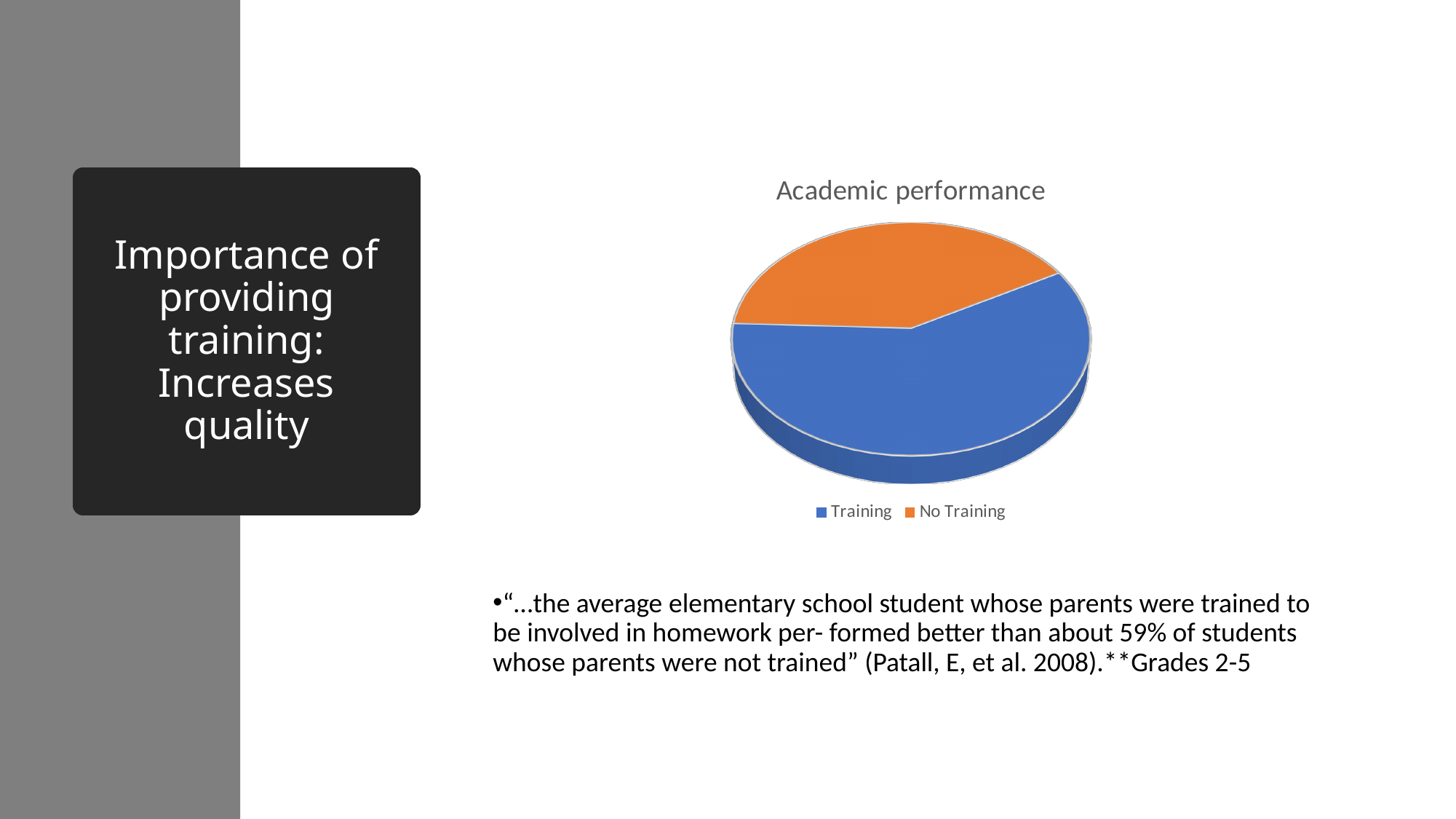
What is the title of the chart? Academic performance What kind of chart is shown on the slide? pie chart What colour is the Training slice in the pie chart? blue Which slice of the pie chart is the smallest? No Training Which slice is larger, Training or No Training? Training How many entries does the chart's legend list? 2 How many slices does the pie chart have? 2 Which slice of the pie chart is the largest? Training Does the Training slice take up more or less than half of the pie? more